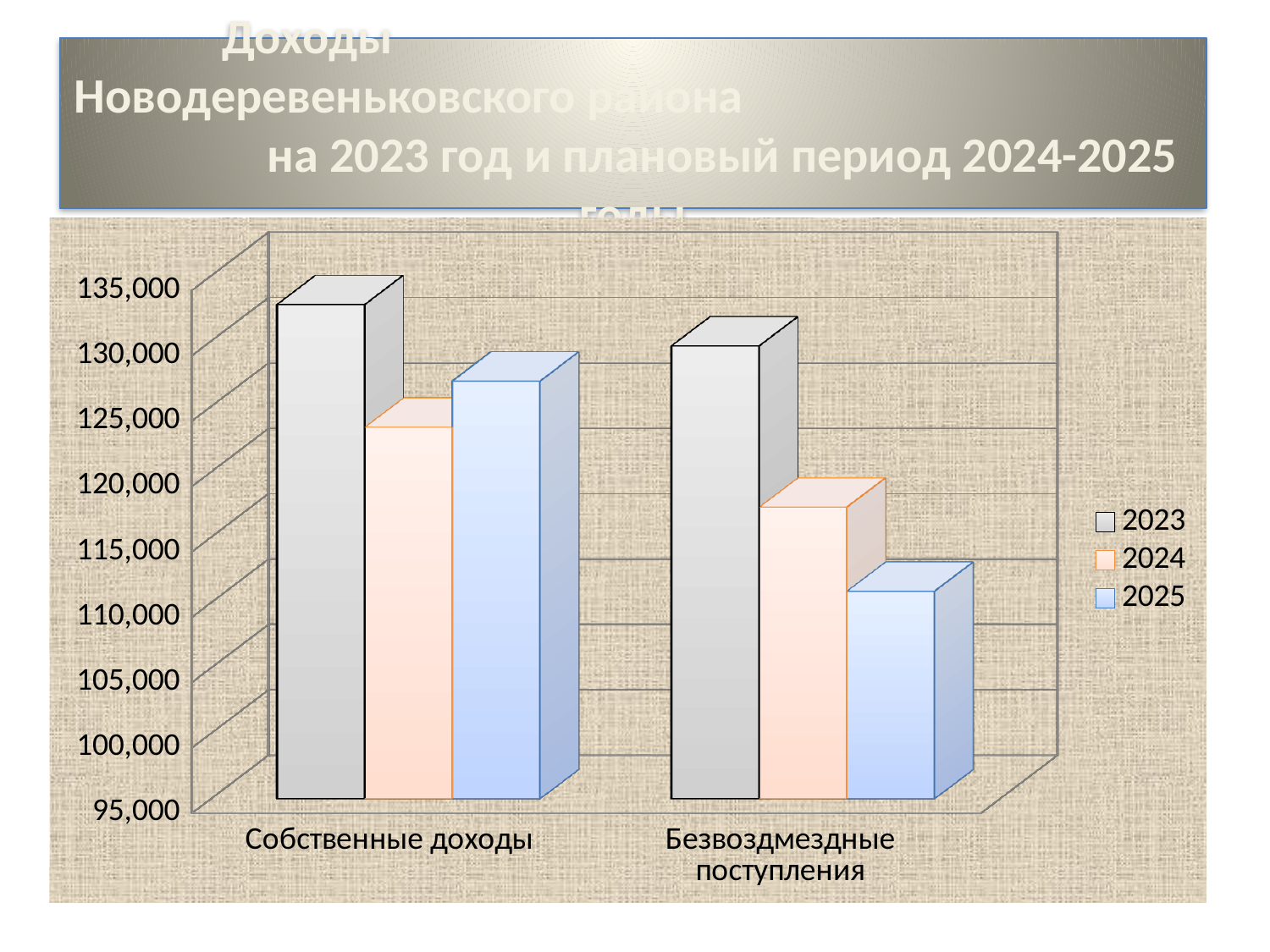
Is the 2023 value for Собственные доходы greater or less than 130,000? greater How many series does the legend list? 3 Is the 2024 value for Безвозмездные поступления greater or less than 120,000? less Is the 2024 value for Собственные доходы greater or less than 130,000? less Which years are listed in the legend? 2023, 2024, 2025 What kind of chart is shown on the slide? bar chart For Безвозмездные поступления, which year has the lowest value? 2025 How many categories are shown on the x axis? 2 For Безвозмездные поступления, do the values rise or fall from 2023 to 2025? fall For Собственные доходы, which is larger: the 2024 value or the 2025 value? 2025